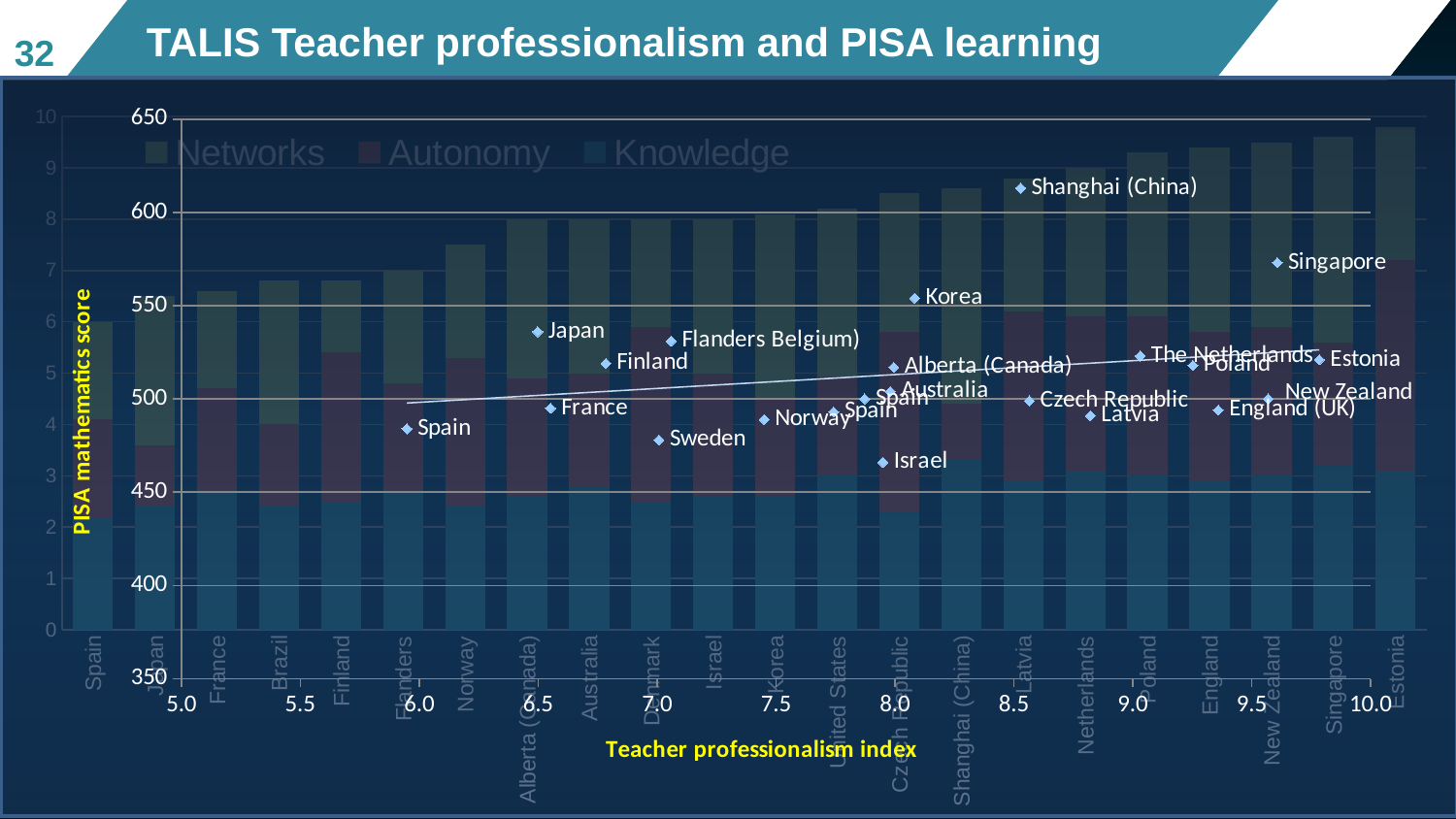
On the scatter plot of PISA mathematics score against teacher professionalism index, which country has the highest PISA mathematics score? Shanghai (China) What kind of chart is the background chart with the Networks, Autonomy and Knowledge legend? Stacked bar chart How many series does the legend of the stacked bar chart in the background list? 3 On the scatter plot, which has the higher PISA mathematics score, Shanghai (China) or Singapore? Shanghai (China) On the scatter plot, is the PISA mathematics score for Israel greater or less than 500? less In the background stacked bar chart, which country has the tallest total bar? Estonia On the scatter plot, is the PISA mathematics score for Singapore greater or less than 550? greater On the scatter plot of PISA mathematics score against teacher professionalism index, which country has the lowest PISA mathematics score? Israel On the scatter plot, is the PISA mathematics score for Shanghai (China) greater or less than 600? greater What is the label of the vertical axis of the scatter plot? PISA mathematics score On the scatter plot, which has the higher PISA mathematics score, Japan or Spain? Japan